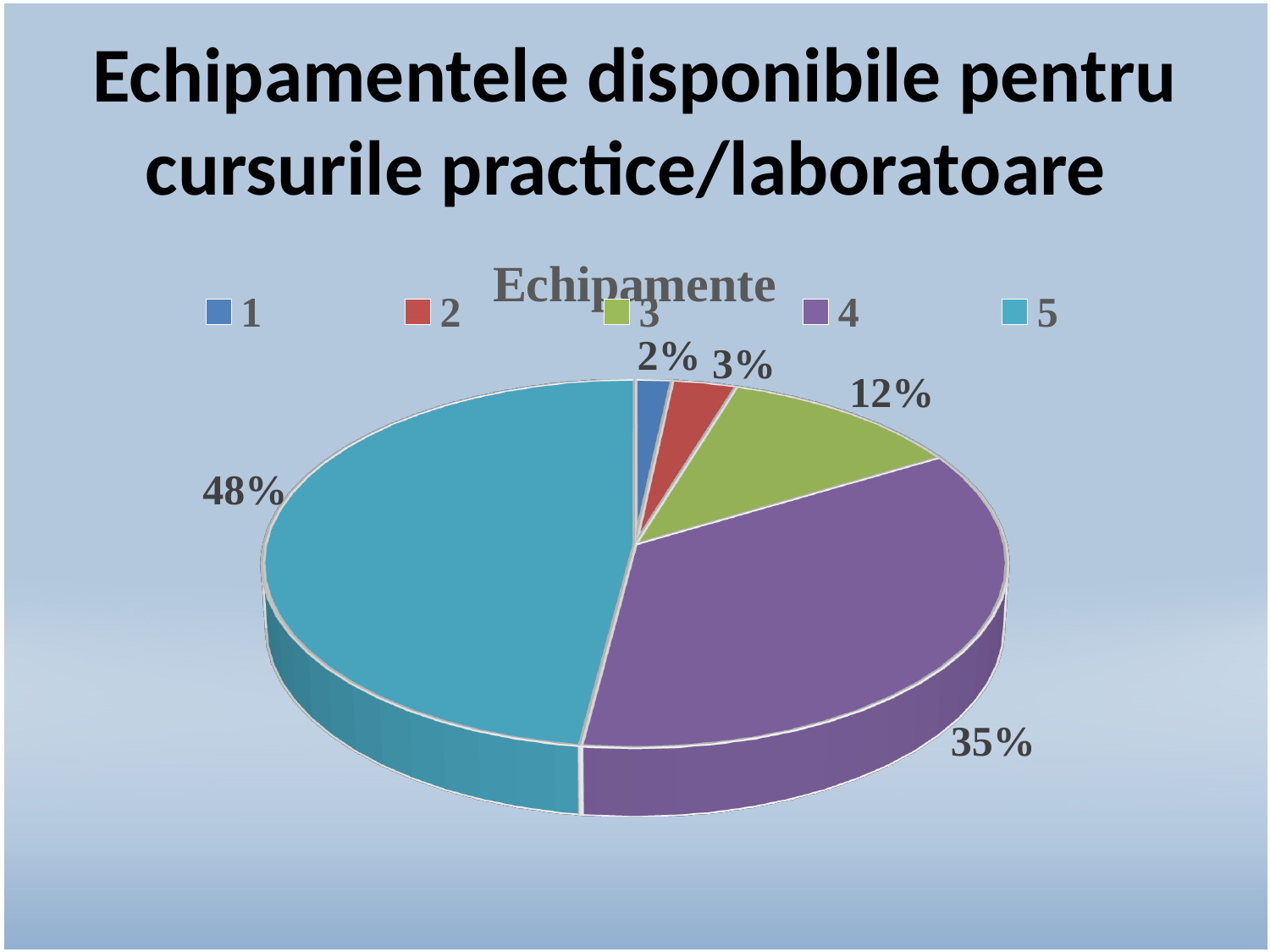
Which category has the smallest slice? 1 What is the chart's title? Echipamente What share of the pie does category 1 have? 2% What kind of chart is shown on the slide? pie chart What colour is the slice for category 4? purple What is the difference in percentage points between category 5 and category 4? 13 What share of the pie does category 3 have? 12% How many categories does the legend list? 5 What share of the pie does category 5 have? 48% What share of the pie does category 4 have? 35% Which category has the largest slice? 5 Which is larger, the slice for category 3 or the slice for category 2? 3